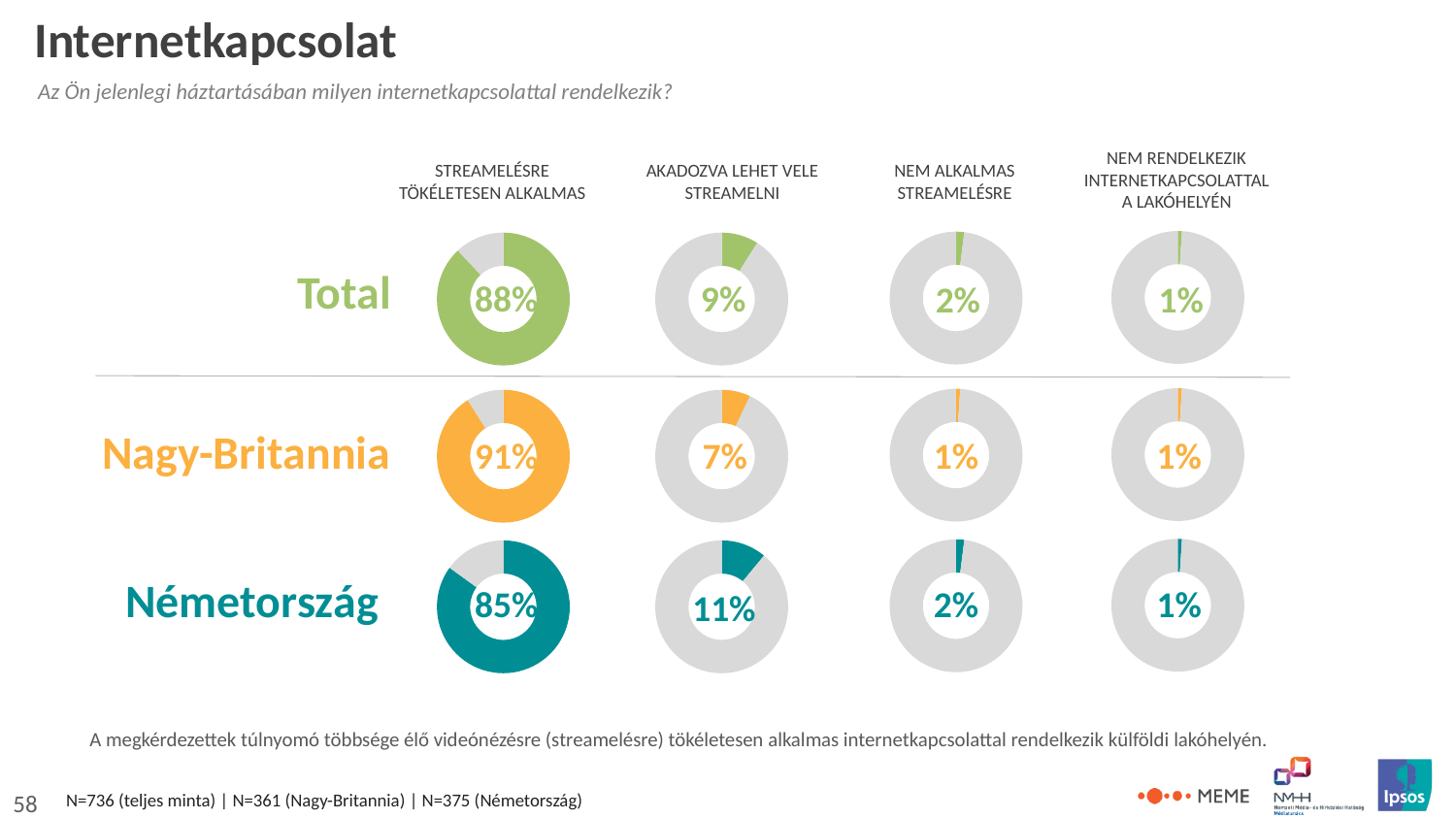
In the Total row, what percentage is shown for 'Streamelésre tökéletesen alkalmas'? 88% What type of chart is used to display the percentages on this slide? Donut (pie) chart Which row (Total, Nagy-Britannia or Németország) has the highest value for 'Streamelésre tökéletesen alkalmas'? Nagy-Britannia In the Németország row, what percentage is shown for 'Streamelésre tökéletesen alkalmas'? 85% In the Németország row, what percentage is shown for 'Nem alkalmas streamelésre'? 2% What is the 'Nem rendelkezik internetkapcsolattal a lakóhelyén' value in the Total row? 1% What colour are the donut charts in the Németország row? Teal Which row (Total, Nagy-Britannia or Németország) has the lowest value for 'Akadozva lehet vele streamelni'? Nagy-Britannia Which is larger: the 'Akadozva lehet vele streamelni' value for Németország or for Total? Németország What is the difference between the 'Streamelésre tökéletesen alkalmas' values for Nagy-Britannia and Németország? 6% How many donut charts are shown on the slide? 12 In the Nagy-Britannia row, what percentage is shown for 'Akadozva lehet vele streamelni'? 7%